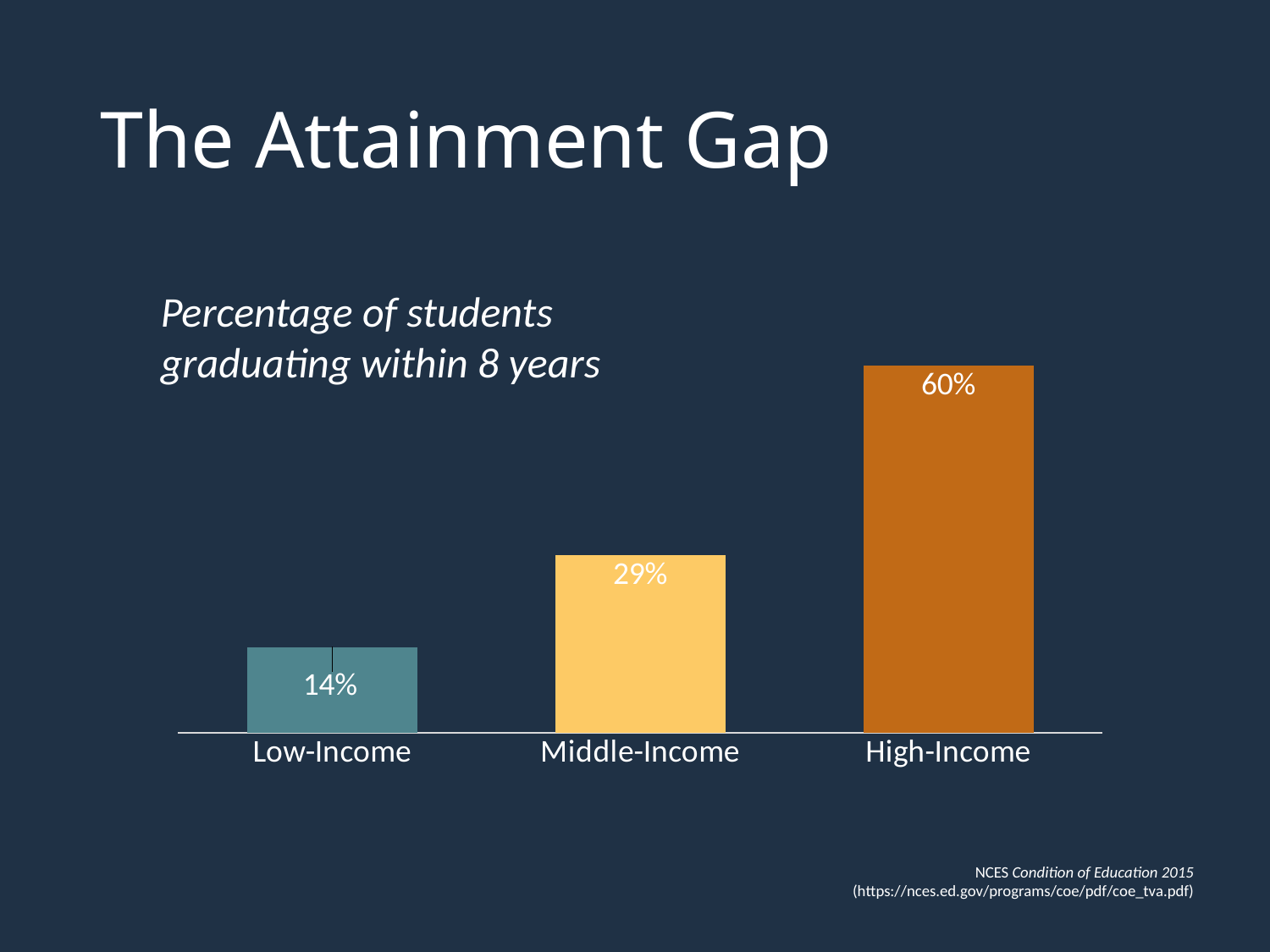
Which category has the highest percentage of students graduating within 8 years? High-Income What is the value for Low-Income? 14% What is the difference between the High-Income and Low-Income values? 46% What does the chart measure, according to the text above it? Percentage of students graduating within 8 years How many categories are shown in the chart? 3 What is the value for High-Income? 60% Which is larger, the value for Middle-Income or the value for High-Income? High-Income What kind of chart is shown on the slide? Bar chart Which category has the lowest percentage of students graduating within 8 years? Low-Income What is the value for Middle-Income? 29% What is the difference between the Middle-Income and Low-Income values? 15% Do the values rise or fall from Low-Income to High-Income along the x axis? Rise